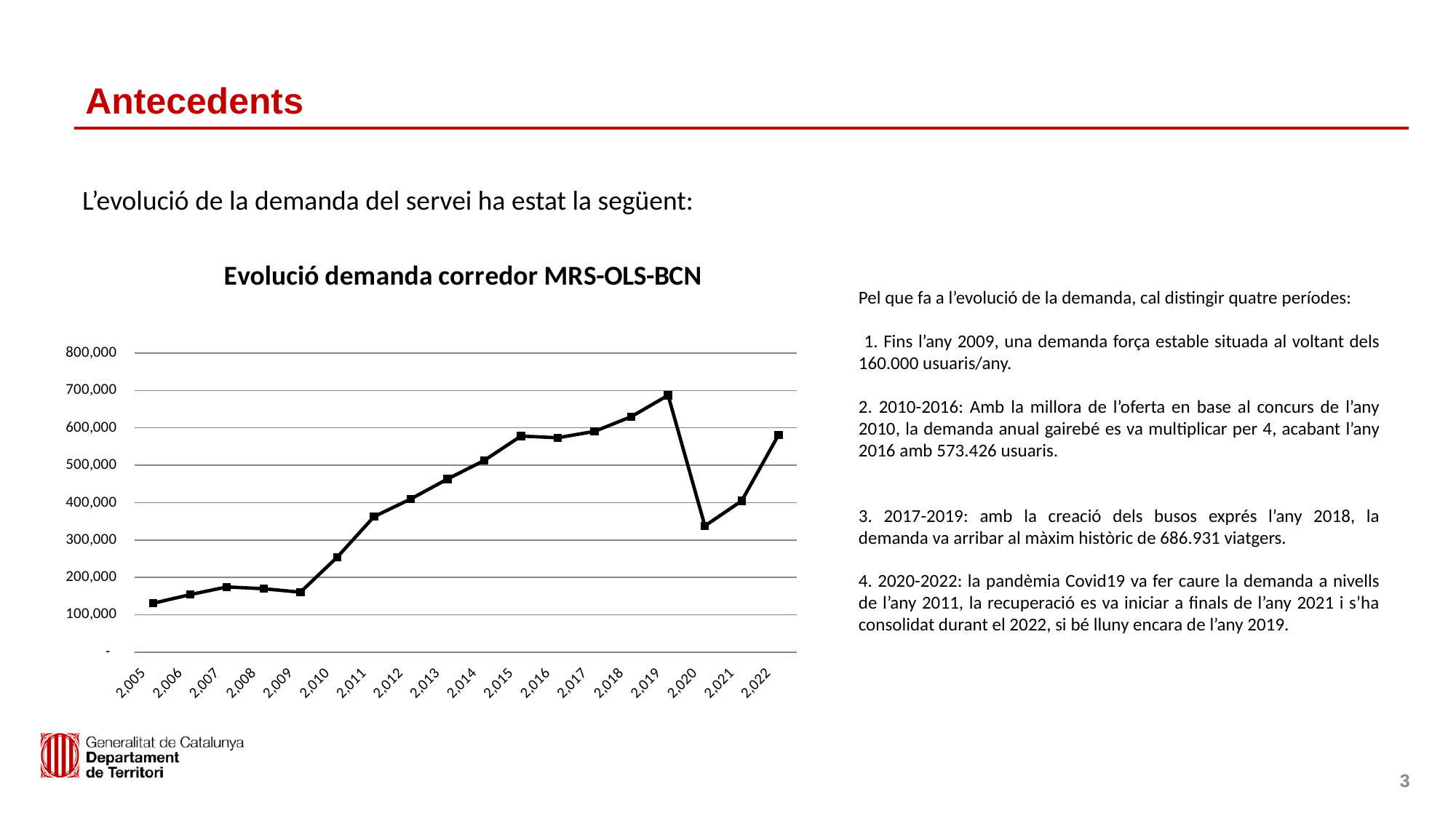
Is the value for 2019 greater or less than 600,000? greater What is the title of the chart? Evolució demanda corredor MRS-OLS-BCN What type of chart is shown on the slide? Line chart Is the value for 2010 greater or less than 200,000? greater Do the values generally rise or fall from 2009 to 2019? Rise Which year has the larger value, 2021 or 2022? 2022 Is the value for 2020 greater or less than 400,000? less How many years are plotted on the x axis of the chart? 18 Which year has the highest value in the chart? 2019 Which year has the larger value, 2019 or 2020? 2019 Which year has the lowest value in the chart? 2005